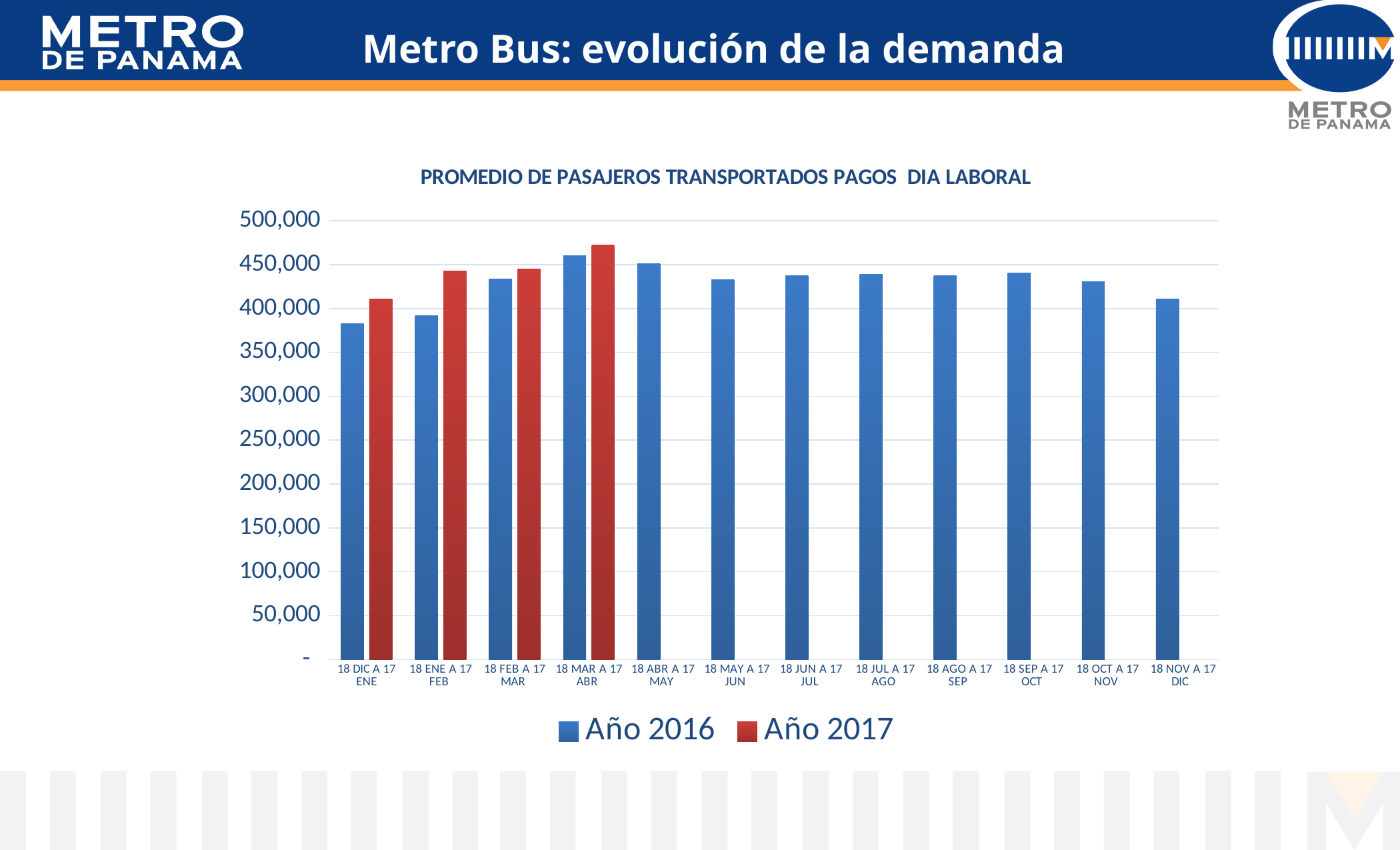
What is the title of the chart? PROMEDIO DE PASAJEROS TRANSPORTADOS PAGOS DIA LABORAL How many periods (categories) are shown on the x axis? 12 How many series does the legend list? 2 Do the Año 2017 values rise or fall from 18 DIC A 17 ENE to 18 MAR A 17 ABR? rise For the period 18 DIC A 17 ENE, which series is larger, Año 2016 or Año 2017? Año 2017 Which period has the highest value for Año 2016? 18 MAR A 17 ABR How many periods have a bar for Año 2017? 4 Which period has the lowest value for Año 2016? 18 DIC A 17 ENE Is the Año 2016 value for 18 DIC A 17 ENE greater or less than 400,000? less Is the Año 2017 value for 18 MAR A 17 ABR greater or less than 450,000? greater Which period has the highest value for Año 2017? 18 MAR A 17 ABR What kind of chart is shown on the slide? bar chart